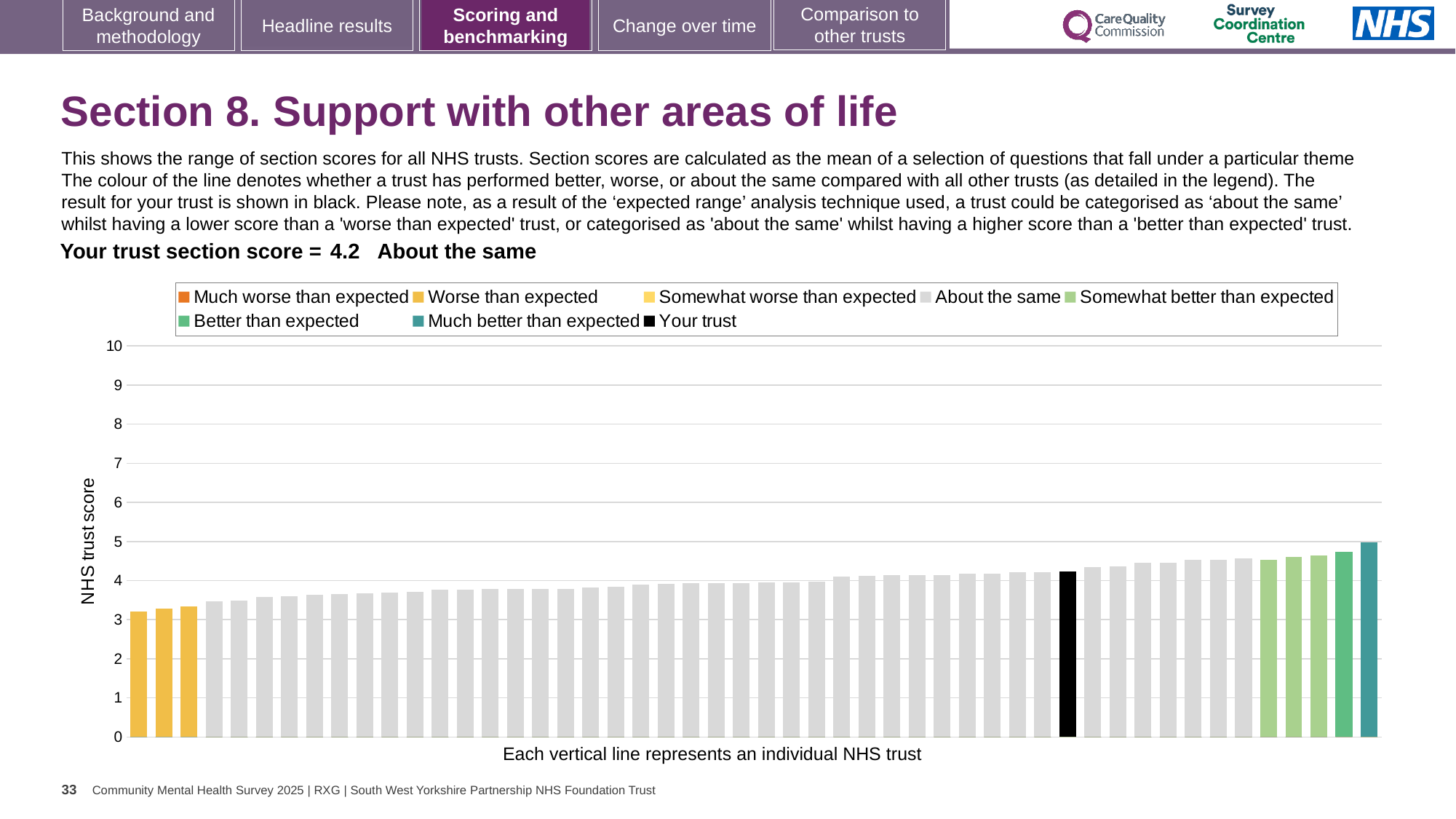
What is the label on the y axis of the chart? NHS trust score Do the bar values rise or fall from left to right along the x axis? rise Is the value of the lowest bar greater or less than 4? less How many bars are coloured as 'Worse than expected'? 3 What kind of chart is shown on the slide? bar chart Which legend category does the highest bar belong to? Much better than expected Which legend category does the lowest bar belong to? Worse than expected Is the value of the lowest bar greater or less than 3? greater What is the section score for your trust? 4.2 How many entries does the chart legend list? 8 Is the value for your trust (the black bar) greater or less than 4? greater What colour is the bar representing your trust? black